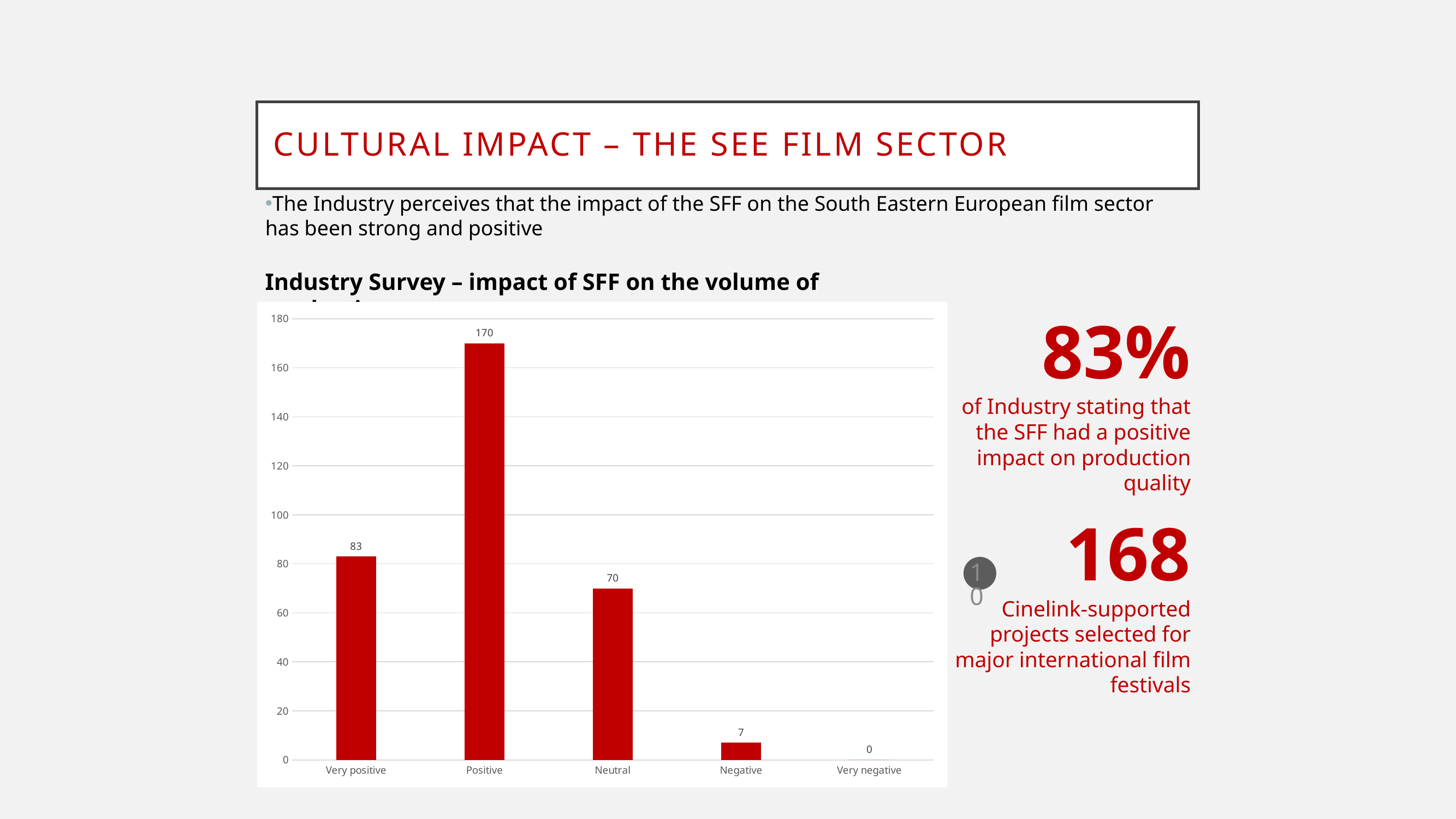
What is the difference between the values for Positive and Very positive? 87 Which category has the highest value? Positive What is the value for Positive? 170 What is the value for Very positive? 83 How many categories are shown on the x axis? 5 What is the value for Negative? 7 What kind of chart is shown on the slide? Bar chart What colour are the bars in the chart? Red Which category has the lowest value? Very negative What is the value for Very negative? 0 What is the value for Neutral? 70 Which is larger, the value for Very positive or the value for Neutral? Very positive